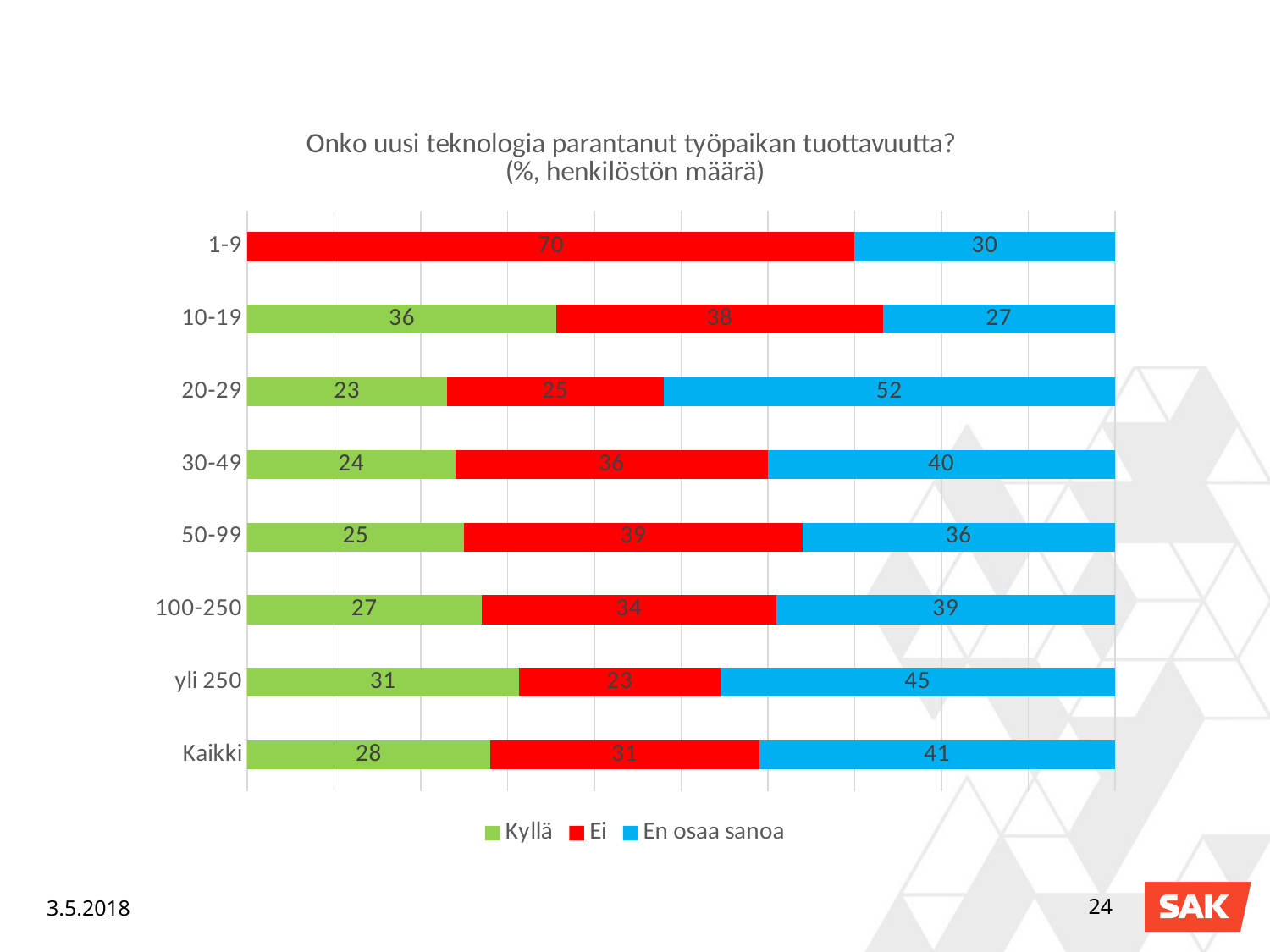
What kind of chart is shown on the slide? Stacked bar chart Which category has the highest value for "En osaa sanoa"? 20-29 How many series does the legend list? 3 What is the value for "En osaa sanoa" in the 20-29 category? 52 How many categories are shown on the chart? 8 In the 10-19 category, how much larger is the "Ei" value than the "Kyllä" value? 2 What is the value for "Kyllä" in the Kaikki category? 28 Which has the larger "Kyllä" value: yli 250 or 100-250? yli 250 Which category has the lowest value for "Ei"? yli 250 What is the value for "Ei" in the 1-9 category? 70 Which category has the highest value for "Kyllä"? 10-19 What is the total of the stacked bar for the 30-49 category? 100